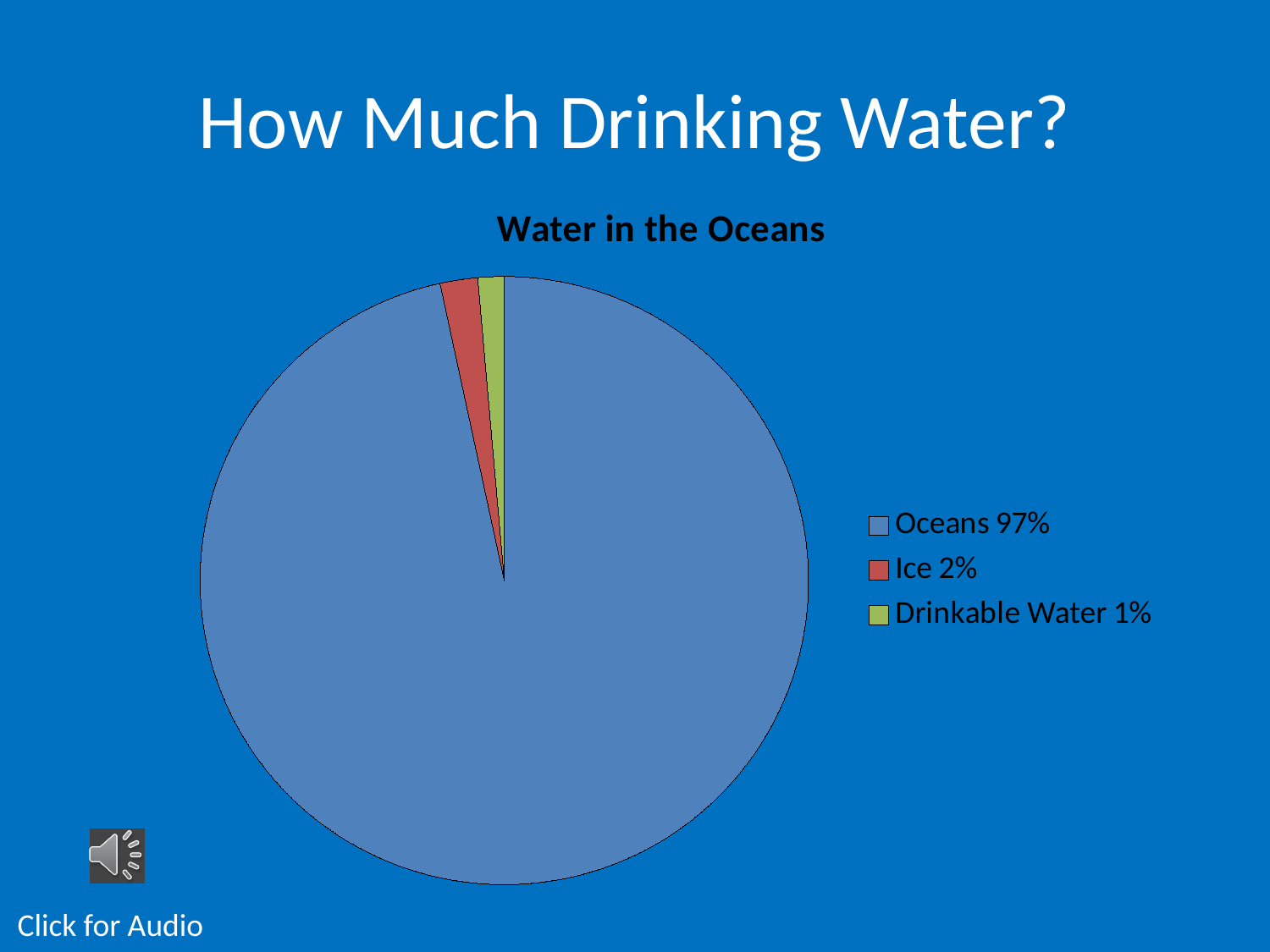
What is the title of the chart? Water in the Oceans What percentage does the legend give for Oceans? 97% Which category has the largest slice of the pie? Oceans Which is larger, the Ice slice or the Drinkable Water slice? Ice What percentage does the legend give for Drinkable Water? 1% What colour is the Ice slice? red What is the difference in percentage points between Oceans and Ice? 95 What percentage does the legend give for Ice? 2% What kind of chart is shown on the slide? pie chart How many slices does the pie chart have? 3 Which category has the smallest slice of the pie? Drinkable Water How many entries does the legend list? 3